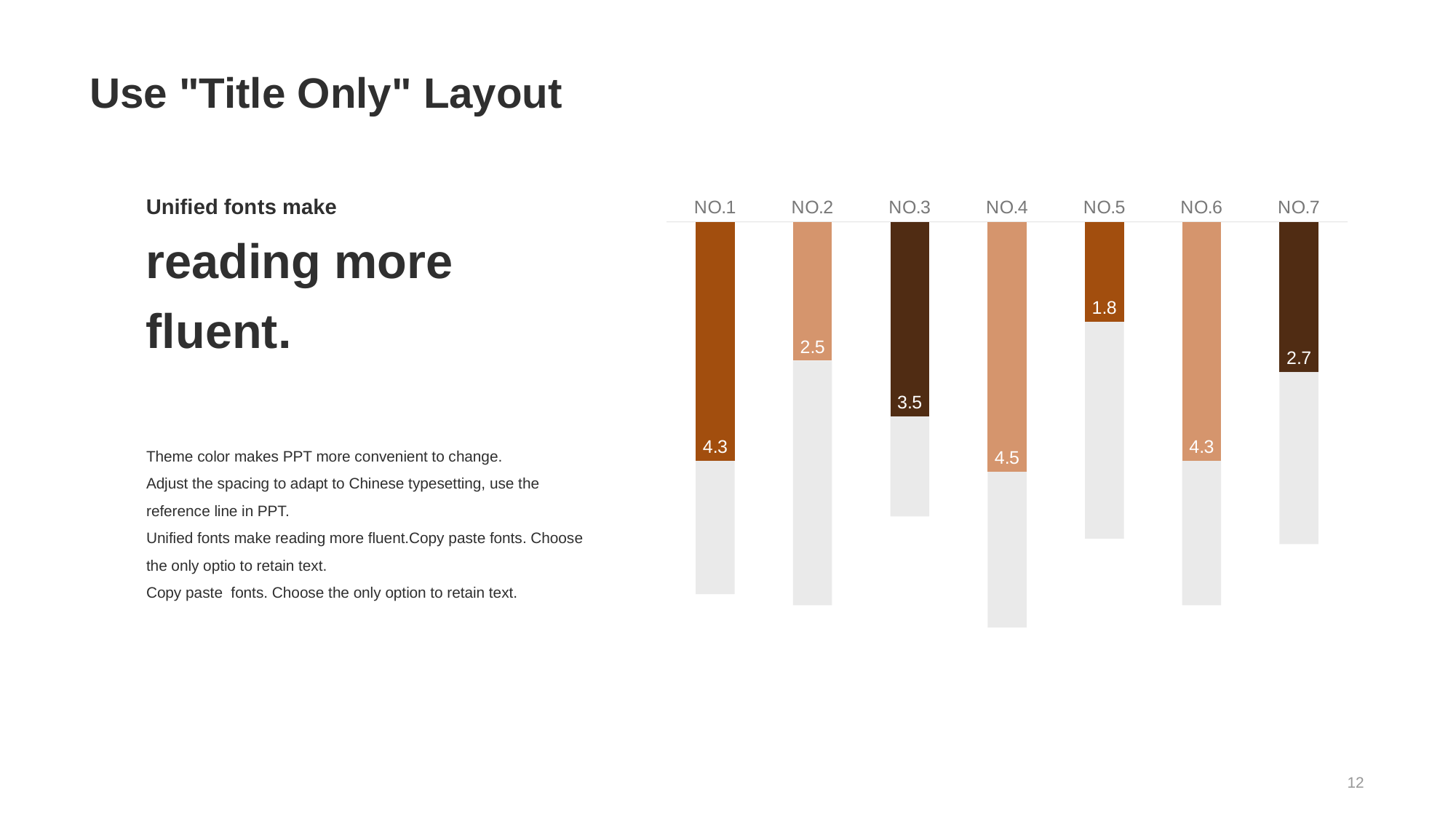
Which has the larger labelled value, NO.6 or NO.7? NO.6 Which category has the lowest labelled value? NO.5 What is the labelled value for NO.2? 2.5 What is the labelled value for NO.3? 3.5 Which category has the highest labelled value? NO.4 What is the labelled value for NO.1? 4.3 What is the labelled value for NO.5? 1.8 What is the labelled value for NO.7? 2.7 What is the difference between the labelled values for NO.4 and NO.5? 2.7 How many categories are shown on the chart? 7 What kind of chart is shown on the slide? Bar chart What is the difference between the labelled values for NO.3 and NO.2? 1.0